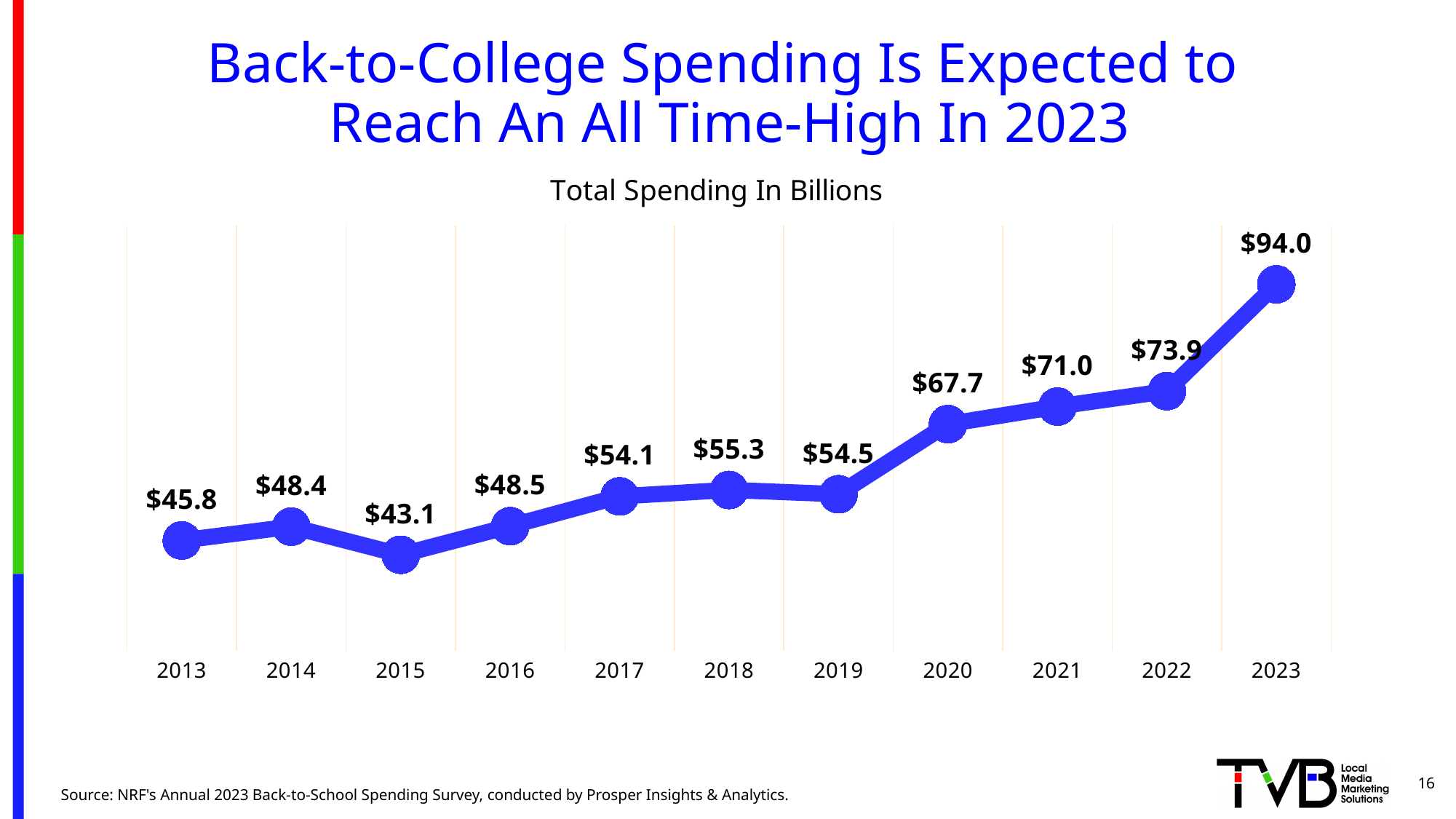
What is the total back-to-college spending shown for 2023? $94.0 Which year has the larger spending value, 2018 or 2019? 2018 What is the total spending value shown for 2015? $43.1 What is the difference between the 2020 and 2019 spending values? $13.2 What is the subtitle shown above the chart? Total Spending In Billions What kind of chart is shown on the slide? Line chart Do the spending values generally rise or fall from 2015 to 2023? Rise Which year has the highest total spending? 2023 Which year has the lowest total spending? 2015 What is the total spending value shown for 2019? $54.5 What is the difference between the 2023 and 2022 spending values? $20.1 How many years are plotted on the chart? 11